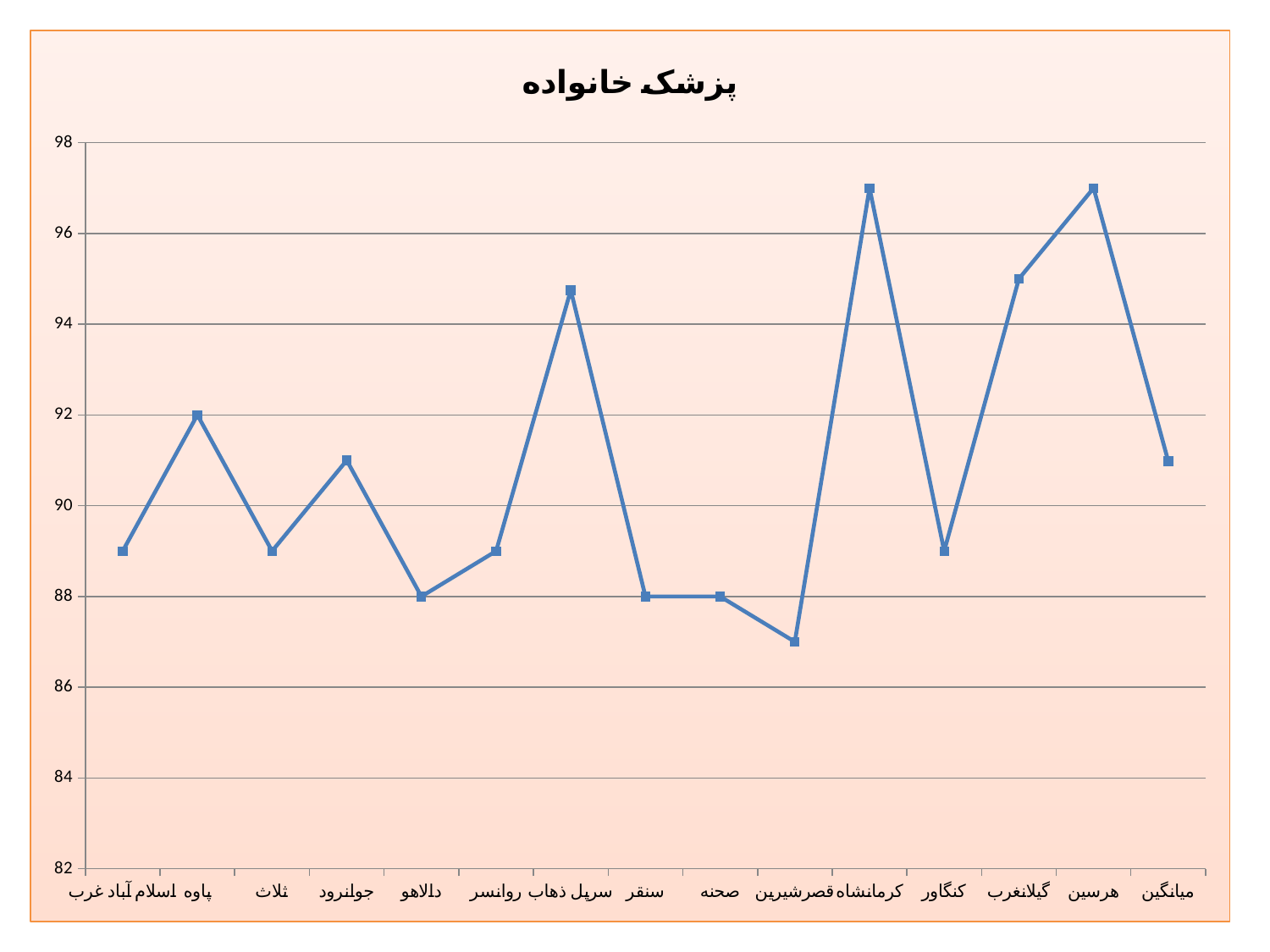
Is the value for اسلام آباد غرب greater or less than 90? less What is the value for پاوه? 92 What is the value for دالاهو? 88 Which category has the lowest value? قصرشیرین Do the values rise or fall from کنگاور to هرسین? rise Is the value for کرمانشاه greater or less than 96? greater Which has the larger value, پاوه or ثلاث? پاوه What is the value for سنقر? 88 What kind of chart is shown on the slide? line chart What is the title of the chart? پزشک خانواده How many categories are plotted along the x axis? 15 What is the difference between the values for پاوه and دالاهو? 4